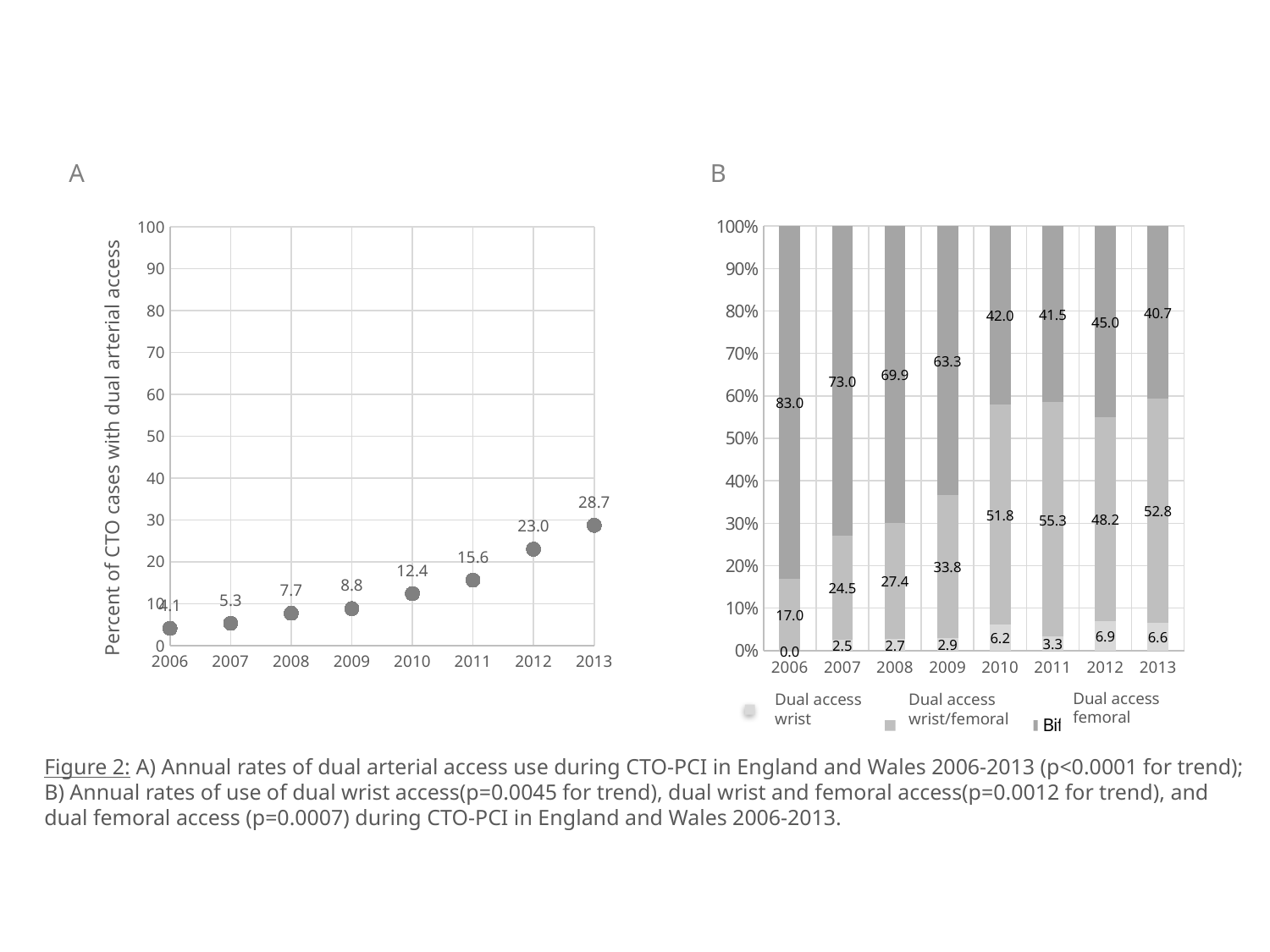
In chart A, what is the difference between the values for 2013 and 2012? 5.7 In chart A, which year has the lowest value? 2006 In chart A, how many years are plotted? 8 In chart B, what is the value for dual access femoral in 2006? 83.0 What kind of chart is chart B? stacked bar chart In chart B, which is larger in 2010: dual access wrist/femoral or dual access femoral? dual access wrist/femoral In chart A, what is the value plotted for 2010? 12.4 In chart B, how many series does the legend list? 3 In chart A, which year has the highest percent of CTO cases with dual arterial access? 2013 In chart A, do the values rise or fall from 2006 to 2013? rise In chart A, what is the percent of CTO cases with dual arterial access in 2013? 28.7 In chart B, what is the value for dual access wrist/femoral in 2011? 55.3